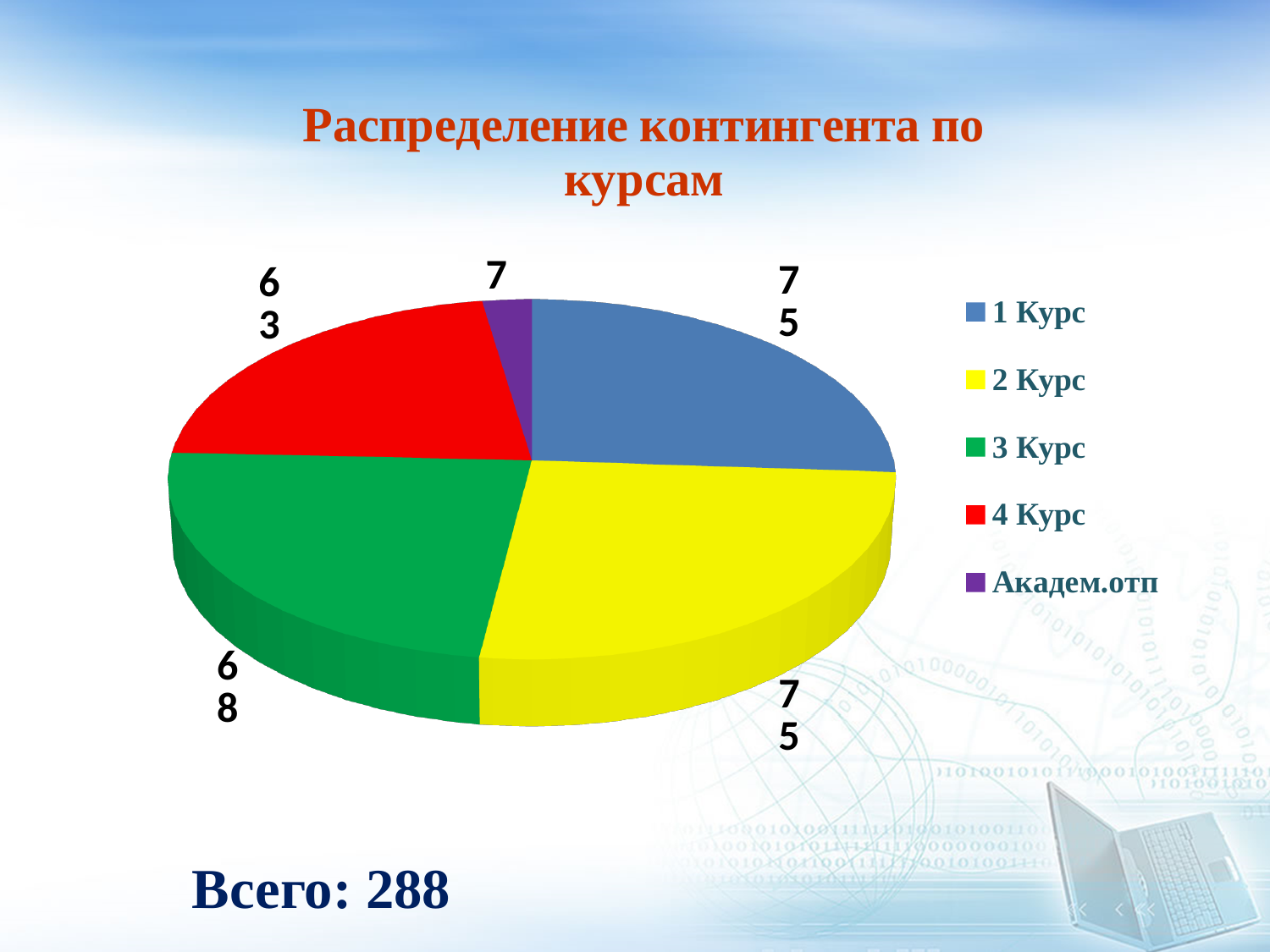
What type of chart is shown on the slide? Pie chart What is the title of the chart? Распределение контингента по курсам What is the value for 1 Курс in the pie chart? 75 What is the value for 3 Курс in the pie chart? 68 Which is larger, the value for 2 Курс or the value for 3 Курс? 2 Курс What is the difference between the values for 3 Курс and 4 Курс? 5 What is the total of all slices in the pie chart? 288 Which category has the smallest slice in the pie chart? Академ.отп What is the difference between the values for 1 Курс and Академ.отп? 68 What is the value for Академ.отп in the pie chart? 7 How many slices does the pie chart have? 5 What is the value for 4 Курс in the pie chart? 63